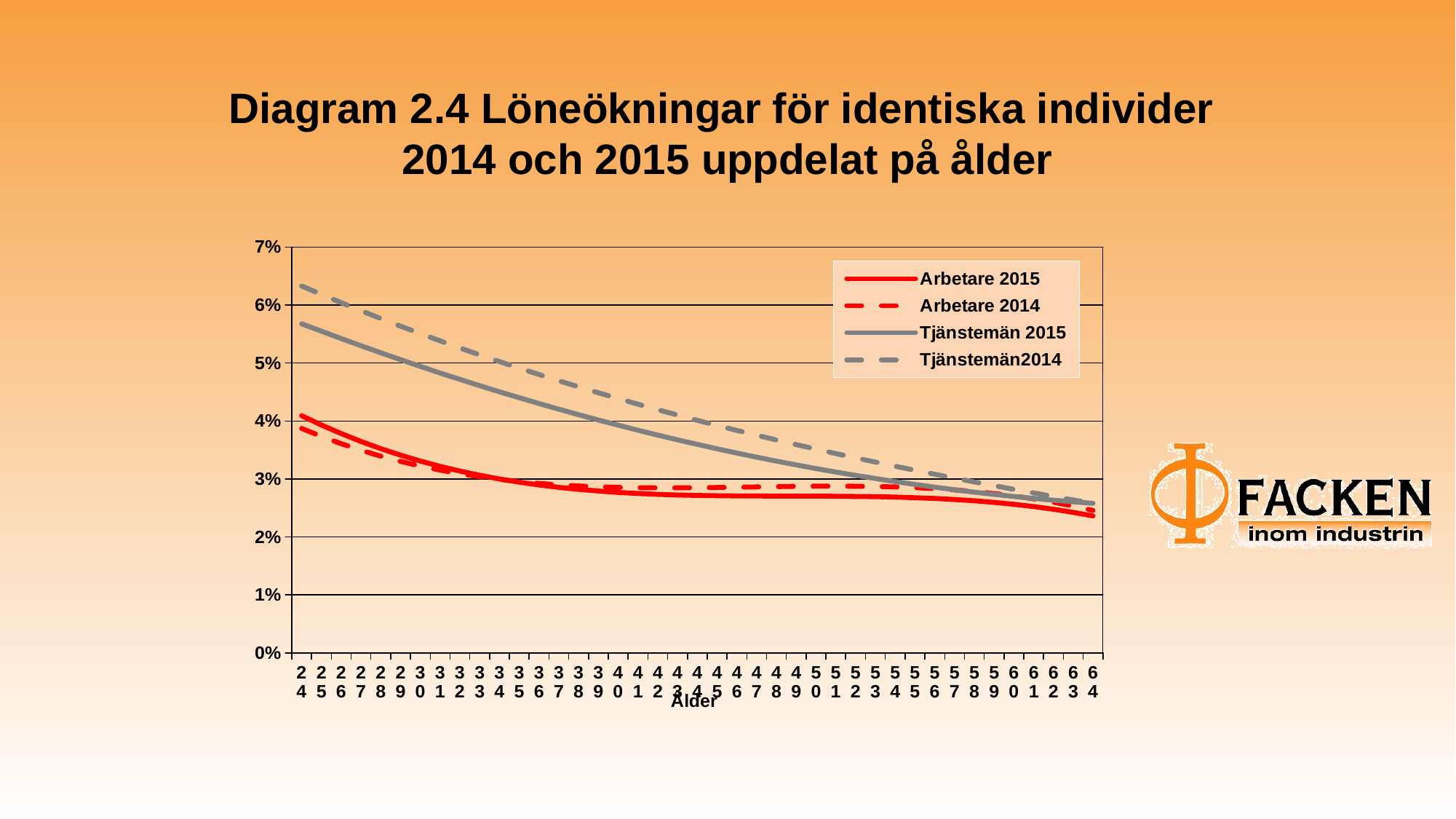
Which series is drawn as a solid grey line? Tjänstemän 2015 What kind of chart is shown on the slide? Line chart Which series has the highest value at age 24? Tjänstemän2014 Is the value for Tjänstemän 2015 at age 44 greater or less than 4%? less Is the value for Tjänstemän2014 at age 24 greater or less than 6%? greater How many age categories are plotted along the x axis? 41 How many series does the legend list? 4 What is the label of the x axis? Ålder Is the value for Tjänstemän 2015 at age 24 greater or less than 5%? greater Does the Tjänstemän 2015 line rise or fall as age increases from 24 to 64? Fall At age 24, which is larger: Tjänstemän 2015 or Arbetare 2015? Tjänstemän 2015